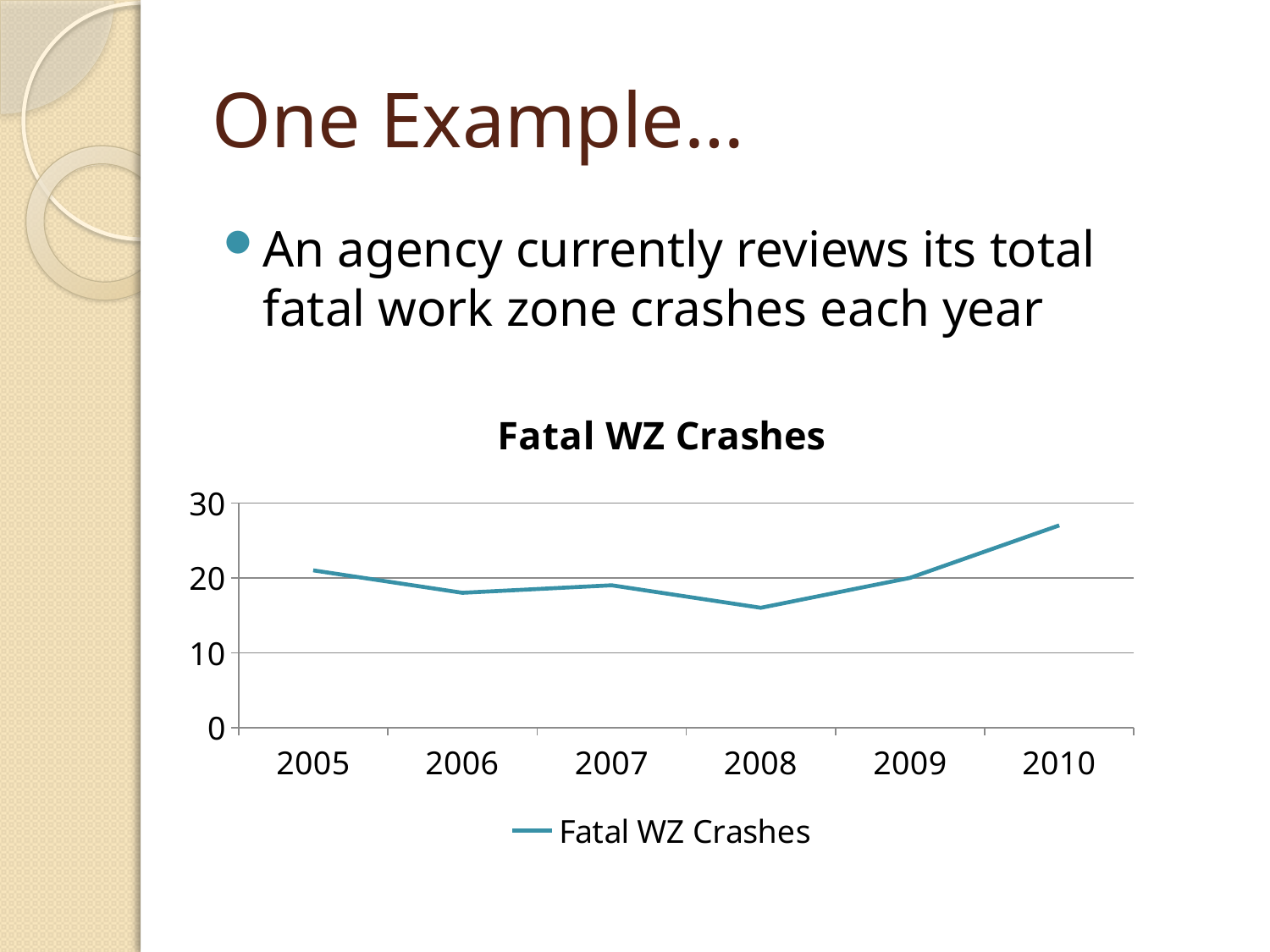
How many series does the legend list? 1 Is the value for 2008 greater or less than 20? less Do the values rise or fall from 2008 to 2010? rise Is the value for 2010 greater or less than 20? greater What type of chart is shown on the slide? line chart What is the title of the chart? Fatal WZ Crashes Is the value for 2006 greater or less than 20? less Which year has more fatal WZ crashes, 2010 or 2008? 2010 Which year has the lowest number of fatal WZ crashes? 2008 What is the first year shown on the x axis? 2005 How many years are plotted along the x axis? 6 Which year has the highest number of fatal WZ crashes? 2010